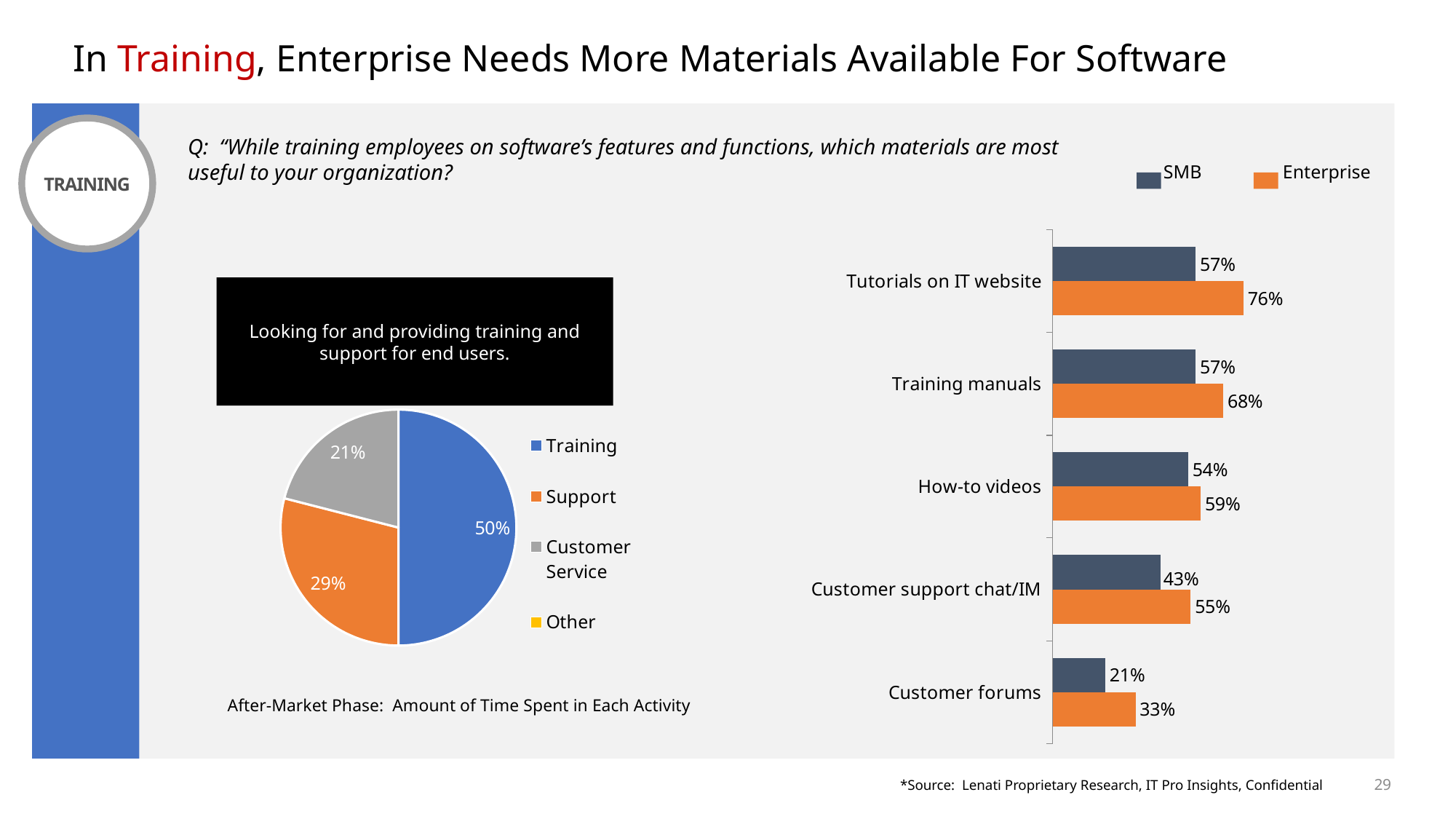
In the pie chart titled 'After-Market Phase: Amount of Time Spent in Each Activity', what share does Support have? 29% In the bar chart on the right, what is the difference between the Enterprise and SMB values for Training manuals? 11% In the pie chart titled 'After-Market Phase: Amount of Time Spent in Each Activity', which activity has the largest share? Training How many categories does the bar chart on the right show? 5 How many entries does the legend of the pie chart list? 4 How many series does the legend of the bar chart on the right list? 2 In the bar chart on the right, which category has the highest Enterprise value? Tutorials on IT website What kind of chart is the chart on the right of the slide? Bar chart In the bar chart on the right, is the SMB value or the Enterprise value larger for How-to videos? Enterprise In the bar chart on the right, which category has the lowest SMB value? Customer forums In the bar chart on the right, what is the SMB value for Customer support chat/IM? 43% In the bar chart on the right, what is the Enterprise value for Tutorials on IT website? 76%